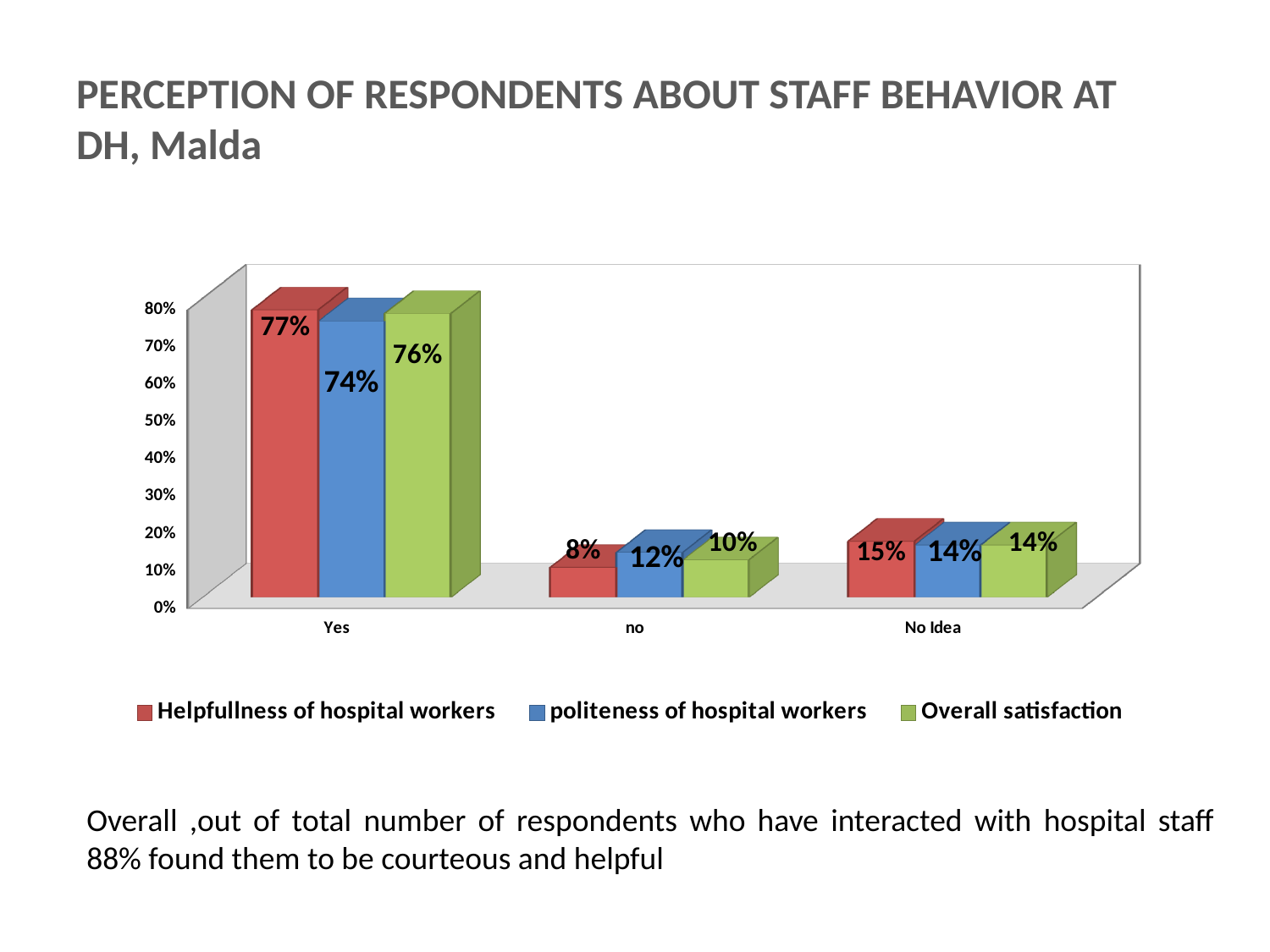
Which category has the highest value for Overall satisfaction? Yes What is the value for Overall satisfaction in the No Idea category? 14% What kind of chart is shown on the slide? bar chart Is the value for Helpfullness of hospital workers in the No Idea category greater or less than 20%? less What is the value for politeness of hospital workers in the no category? 12% What is the difference between the Helpfullness of hospital workers and politeness of hospital workers values in the Yes category? 3% Which is larger in the no category: politeness of hospital workers or Overall satisfaction? politeness of hospital workers How many categories are shown on the x axis? 3 How many series does the legend list? 3 Which colour represents Overall satisfaction in the chart? green What is the value for Helpfullness of hospital workers in the Yes category? 77% Which category has the lowest value for Helpfullness of hospital workers? no